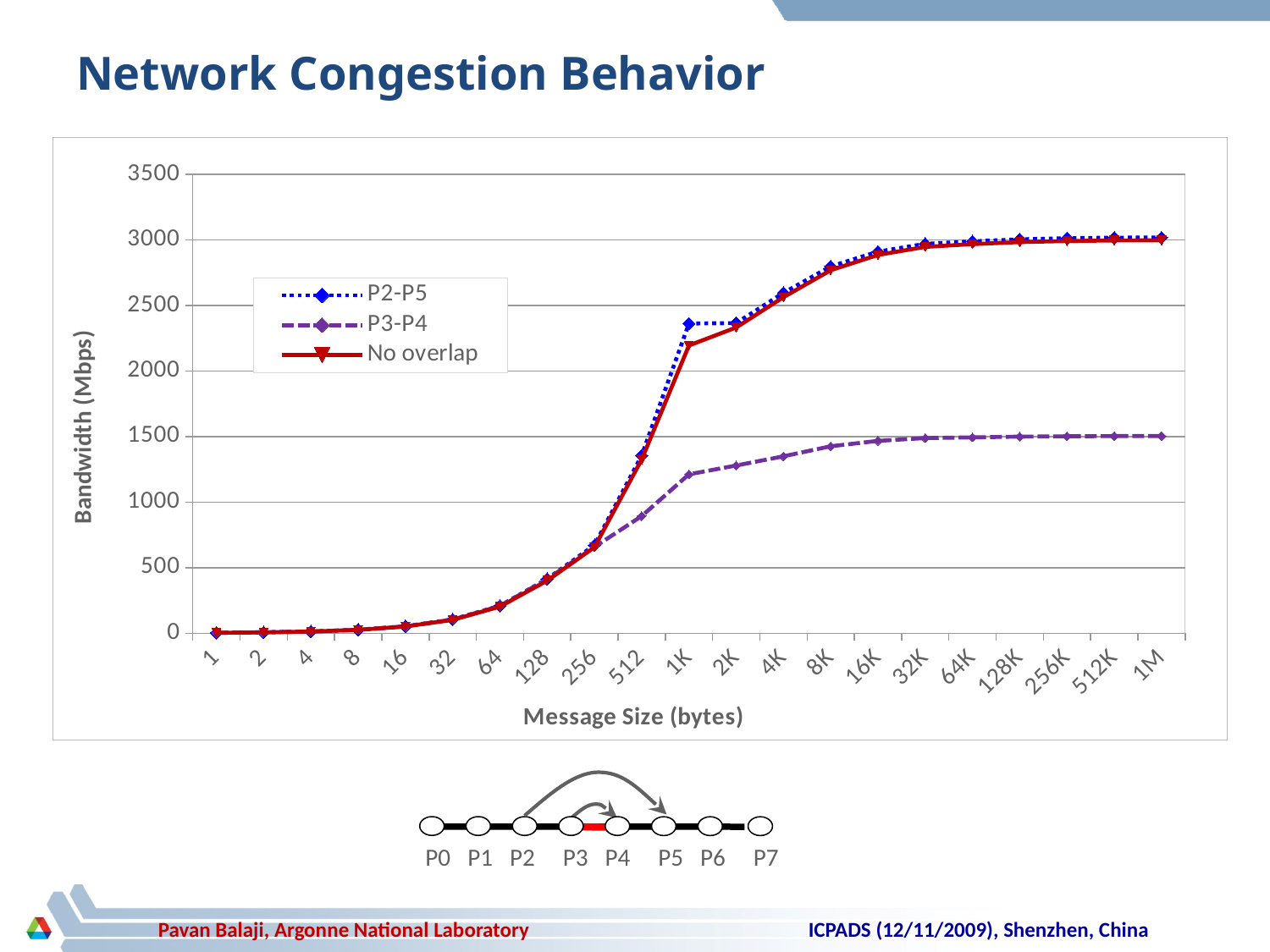
At a message size of 512 bytes, is the bandwidth for P3-P4 greater or less than 1000 Mbps? less How many series does the legend list? 3 At a message size of 1M, is the bandwidth for P2-P5 greater or less than 2500 Mbps? greater Which series has the lowest bandwidth at a message size of 1M? P3-P4 At a message size of 1M, is the bandwidth for P3-P4 greater or less than 1000 Mbps? greater How many message sizes are plotted along the x axis? 21 What is the label of the y axis? Bandwidth (Mbps) What is the label of the x axis? Message Size (bytes) What kind of chart is shown on the slide? line chart At a message size of 4K, which series has the higher bandwidth, P2-P5 or P3-P4? P2-P5 Does the bandwidth for the No overlap series rise or fall as message size increases? rise